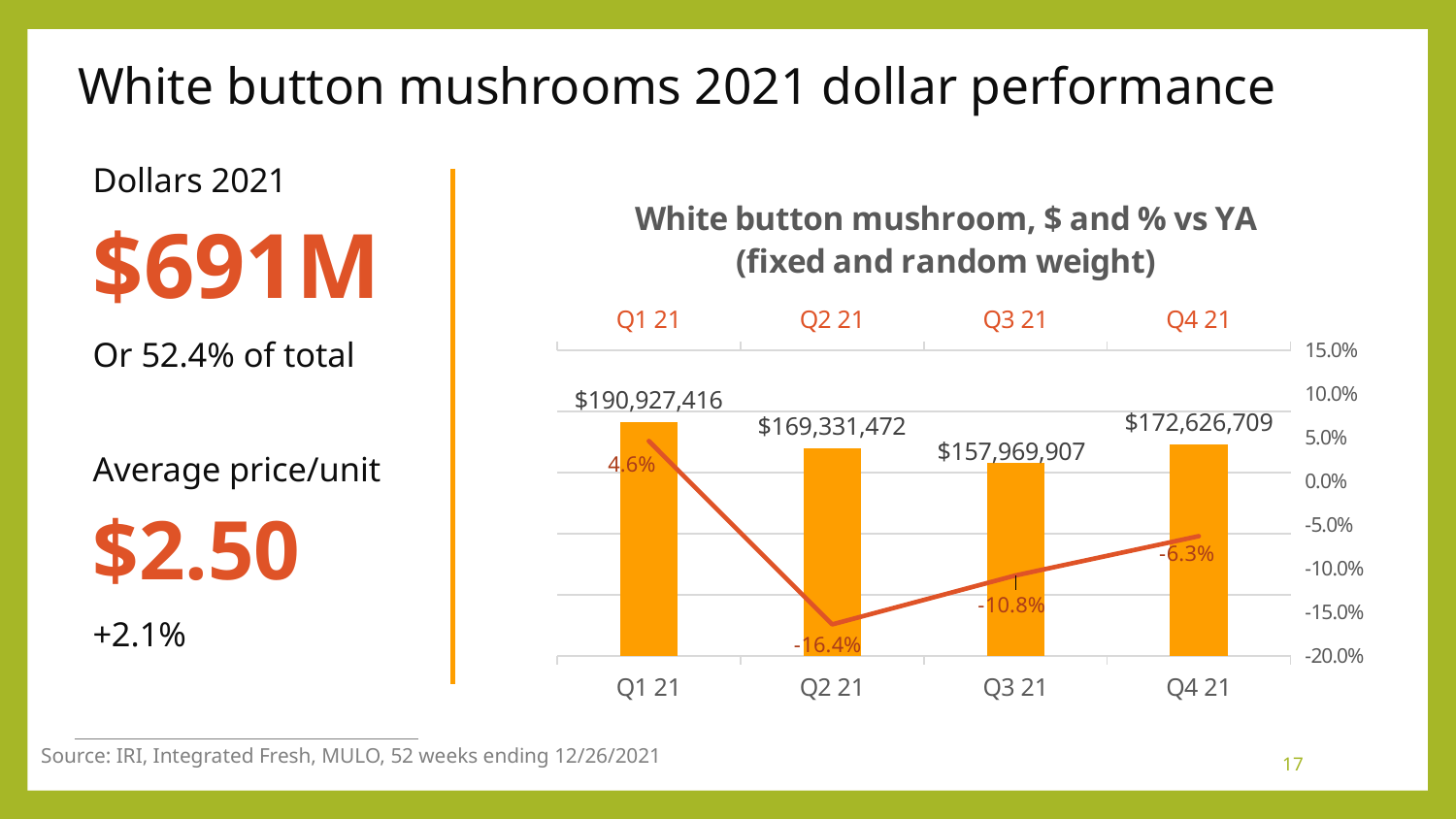
What is the difference in dollar value between Q1 21 and Q2 21? $21,595,944 Which quarter has the highest dollar value? Q1 21 Is the % vs YA value for Q3 21 greater or less than -5.0%? less What is the title of the chart? White button mushroom, $ and % vs YA (fixed and random weight) What is the dollar value shown for Q3 21? $157,969,907 What is the % vs YA value shown for Q4 21? -6.3% What is the % vs YA value shown for Q2 21? -16.4% Which has a larger dollar value, Q2 21 or Q4 21? Q4 21 How many quarters are plotted on the chart? 4 What is the dollar value shown for Q1 21? $190,927,416 Which quarter has the lowest % vs YA value? Q2 21 What kind of chart is shown on the slide? Combined bar and line chart